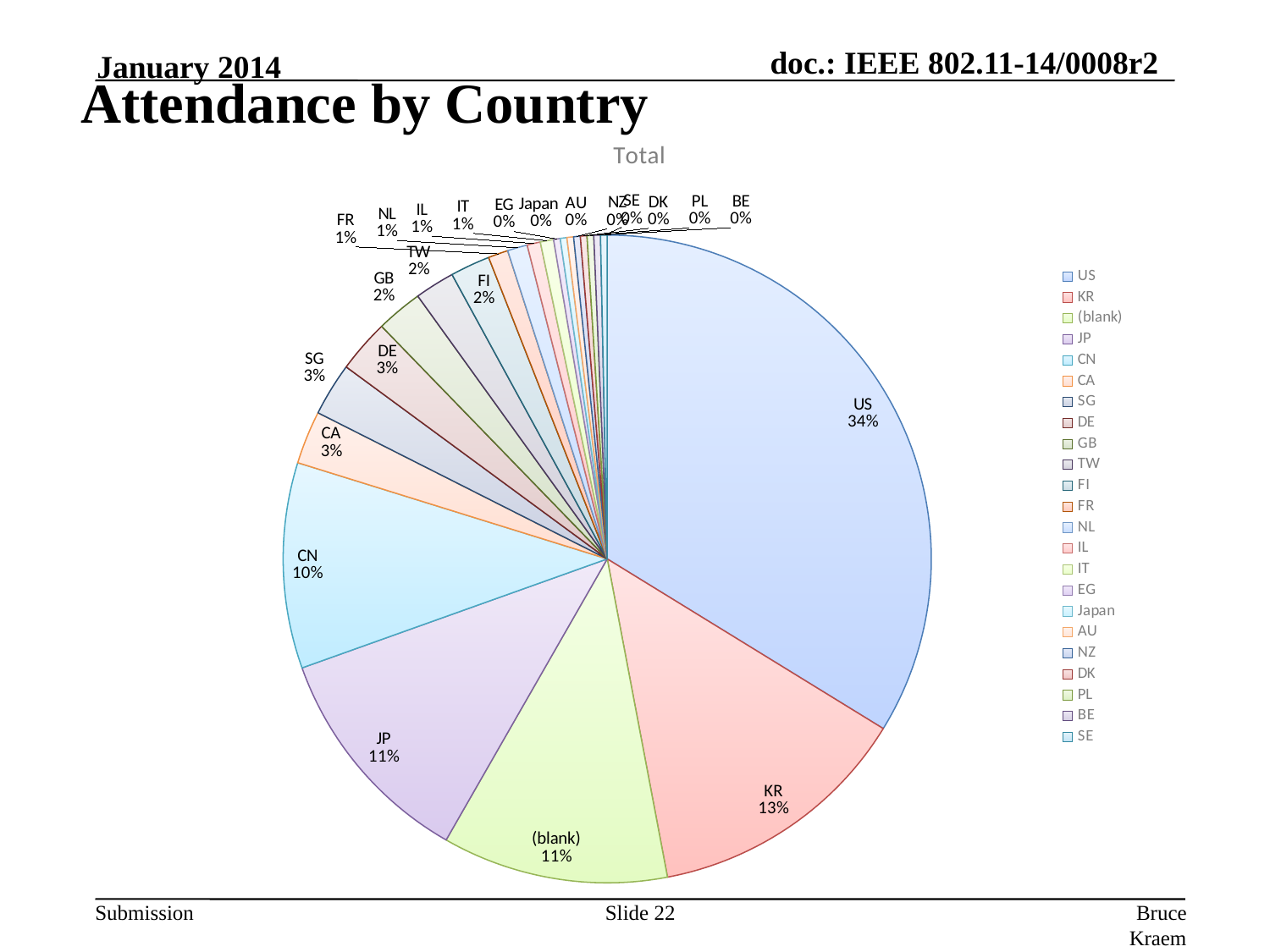
What is the difference in percentage points between US and KR? 21 How many slices does the pie chart have? 23 What percentage is shown for the (blank) slice? 11% What share of attendance does US have? 34% What is the chart's title? Total What kind of chart is shown on the slide? pie chart What percentage is shown for CN? 10% Which country has the largest slice of the pie? US What percentage is shown for GB? 2% What percentage is shown for CA? 3% Which is larger, the slice for KR or the slice for JP? KR What percentage is shown for KR? 13%